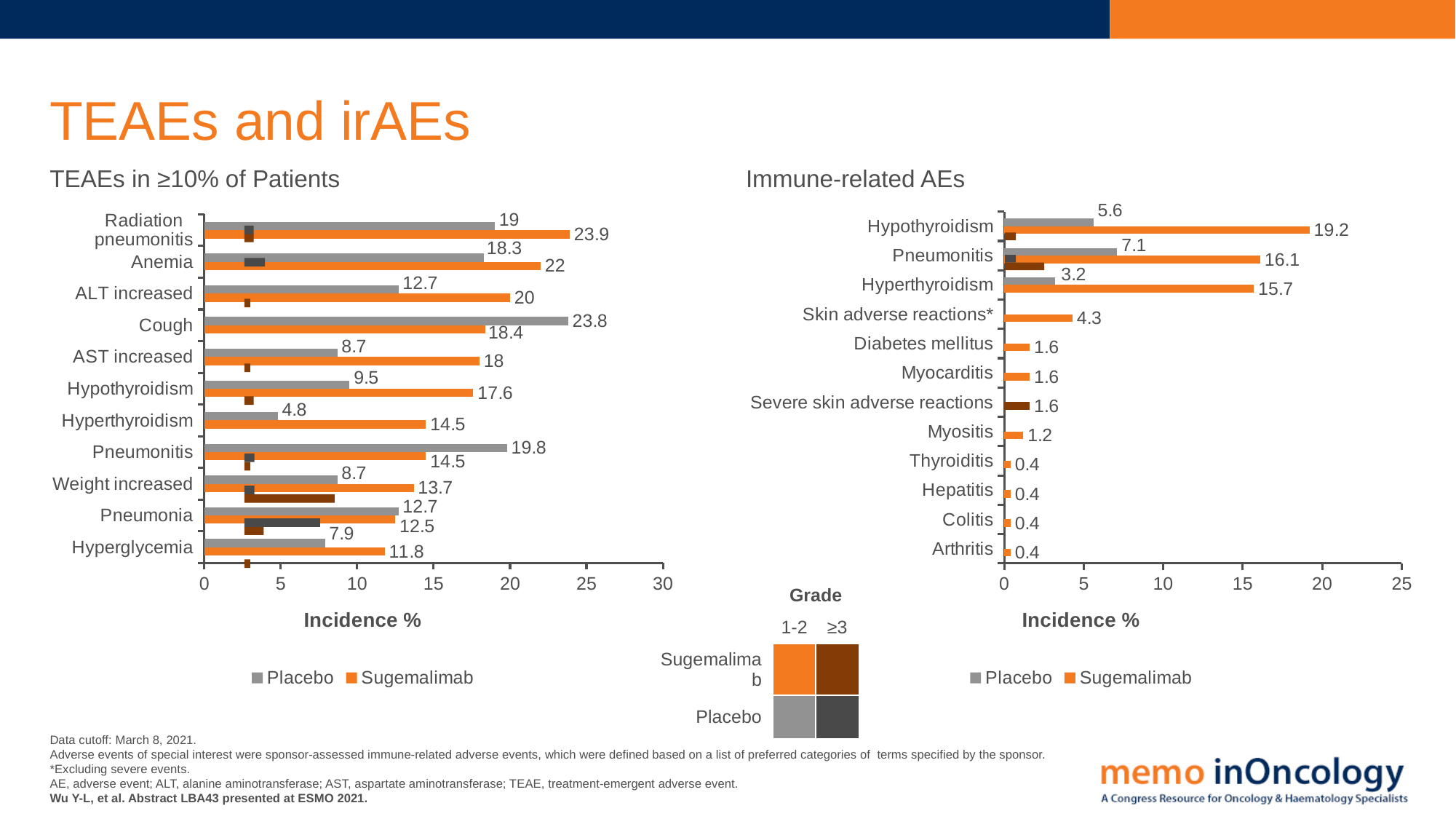
In the 'Immune-related AEs' chart, what is the Placebo incidence for Pneumonitis? 7.1 In the 'TEAEs in ≥10% of Patients' chart, which is larger for Pneumonitis: Placebo or Sugemalimab? Placebo In the 'TEAEs in ≥10% of Patients' chart, what is the Sugemalimab incidence for Radiation pneumonitis? 23.9 In the 'TEAEs in ≥10% of Patients' chart, what is the difference between the Sugemalimab and Placebo values for Hyperthyroidism? 9.7 How many categories are shown in the 'TEAEs in ≥10% of Patients' chart? 11 In the 'TEAEs in ≥10% of Patients' chart, what is the Placebo incidence for Cough? 23.8 How many categories are shown in the 'Immune-related AEs' chart? 12 In the 'TEAEs in ≥10% of Patients' chart, which category has the highest Sugemalimab value? Radiation pneumonitis In the 'Immune-related AEs' chart, what is the Sugemalimab incidence for Hypothyroidism? 19.2 What type of chart is the 'Immune-related AEs' chart? Bar chart In the 'Immune-related AEs' chart, what is the difference between the Sugemalimab and Placebo values for Hyperthyroidism? 12.5 In the 'TEAEs in ≥10% of Patients' chart, which category has the lowest Placebo value? Hyperthyroidism